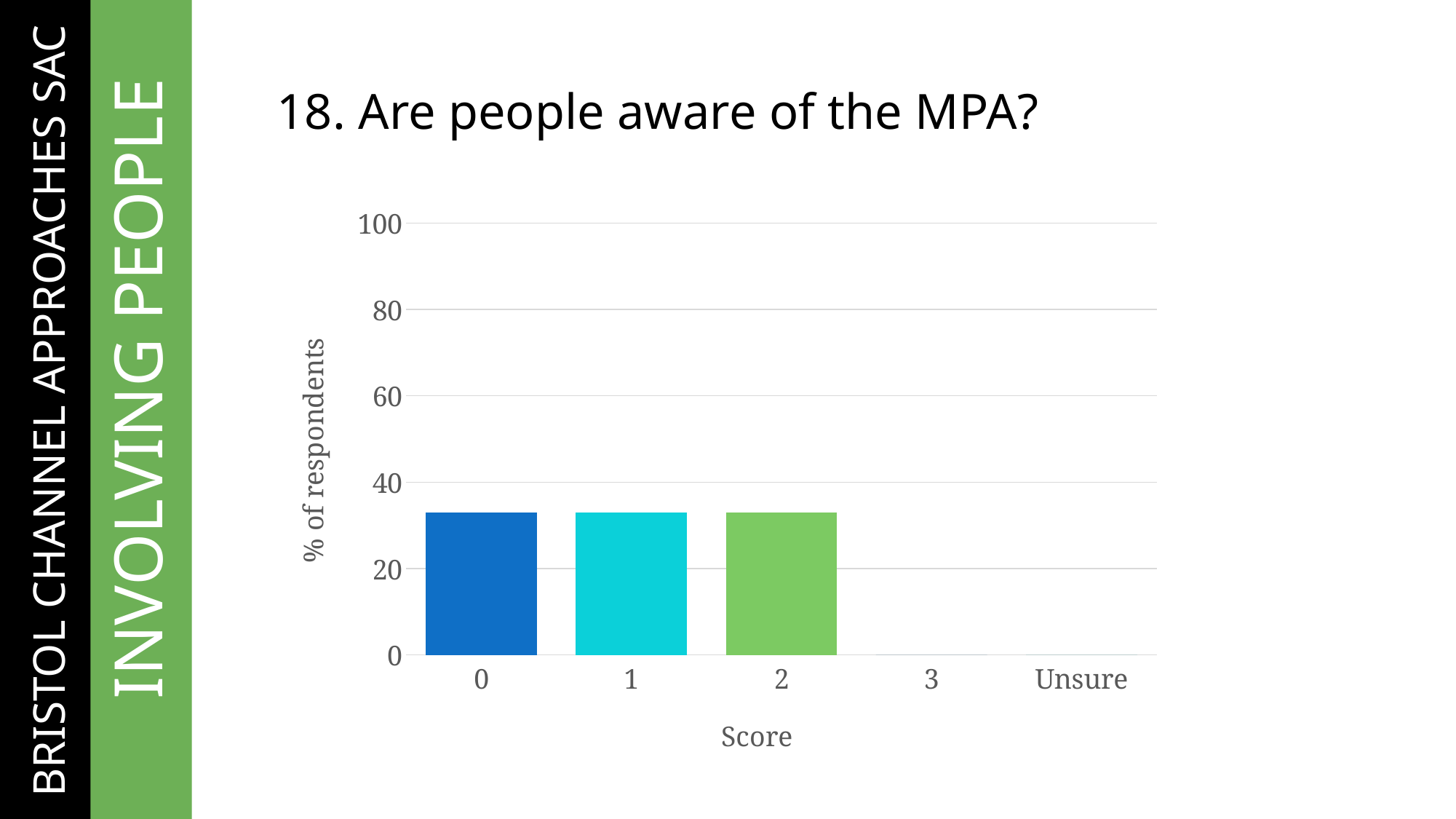
What kind of chart is shown on the slide? bar chart Is the value for score 2 greater or less than 20? greater How many categories are shown on the x axis of the chart? 5 What is the title of the chart's vertical axis? % of respondents Which is larger, the value for score 2 or the value for Unsure? score 2 Which is larger, the value for score 0 or the value for score 3? score 0 Is the value for score 1 greater or less than 40? less Is the value for score 0 greater or less than 20? greater What is the title of the chart's horizontal axis? Score What is the value for Unsure? 0 What is the value for score 3? 0